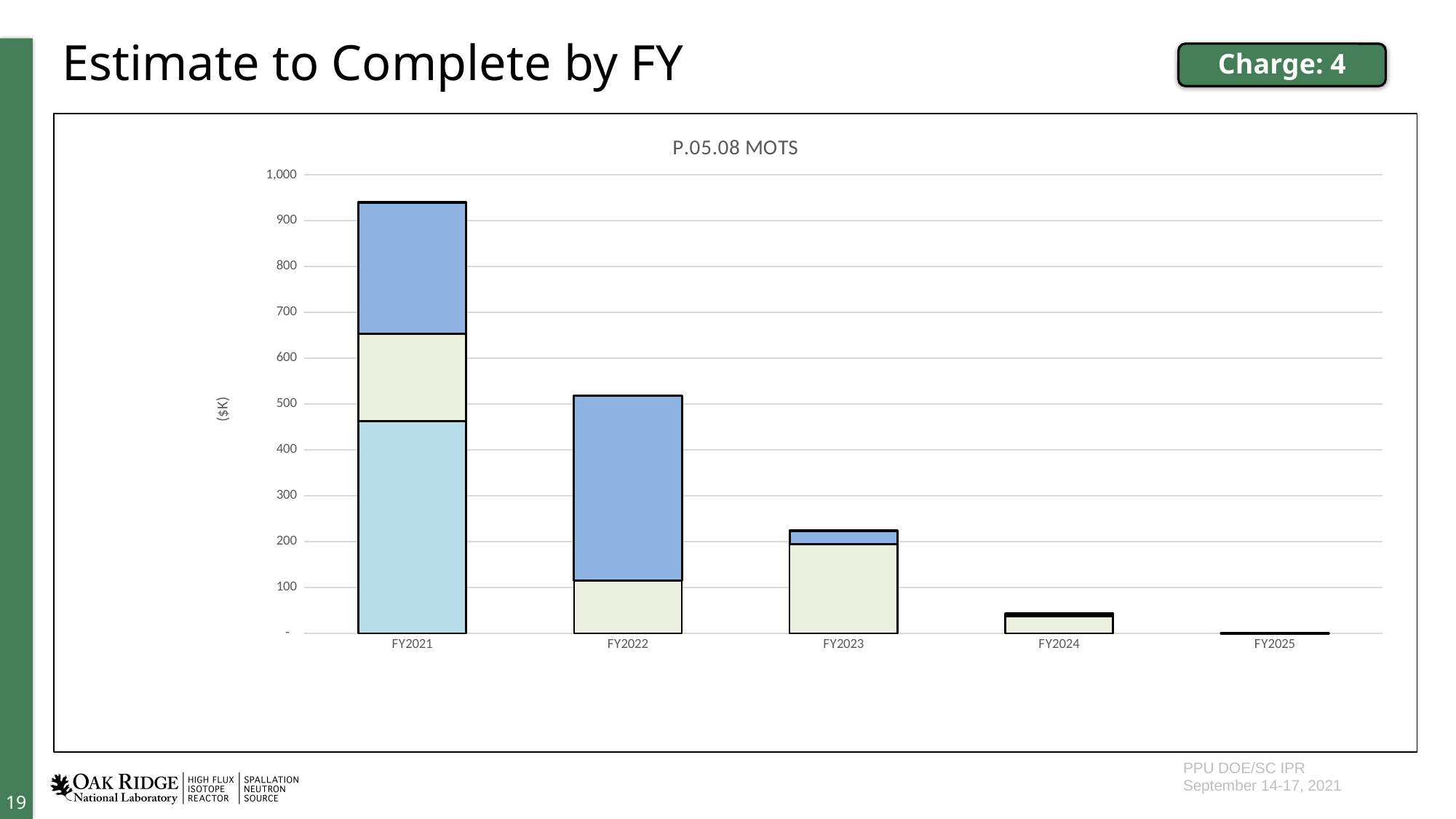
What kind of chart is shown on the slide? stacked bar chart Is the total value for FY2022 greater or less than 500? greater What is the title of the chart? P.05.08 MOTS Do the total bar heights rise or fall from FY2021 to FY2025? fall Is the total value for FY2024 greater or less than 100? less What unit label is shown on the vertical axis of the chart? ($K) Is the total value for FY2023 greater or less than 300? less How many fiscal years are shown on the x axis of the chart? 5 Which fiscal year has the tallest stacked bar? FY2021 Which fiscal year has the shortest stacked bar? FY2025 Which has a larger total, FY2022 or FY2023? FY2022